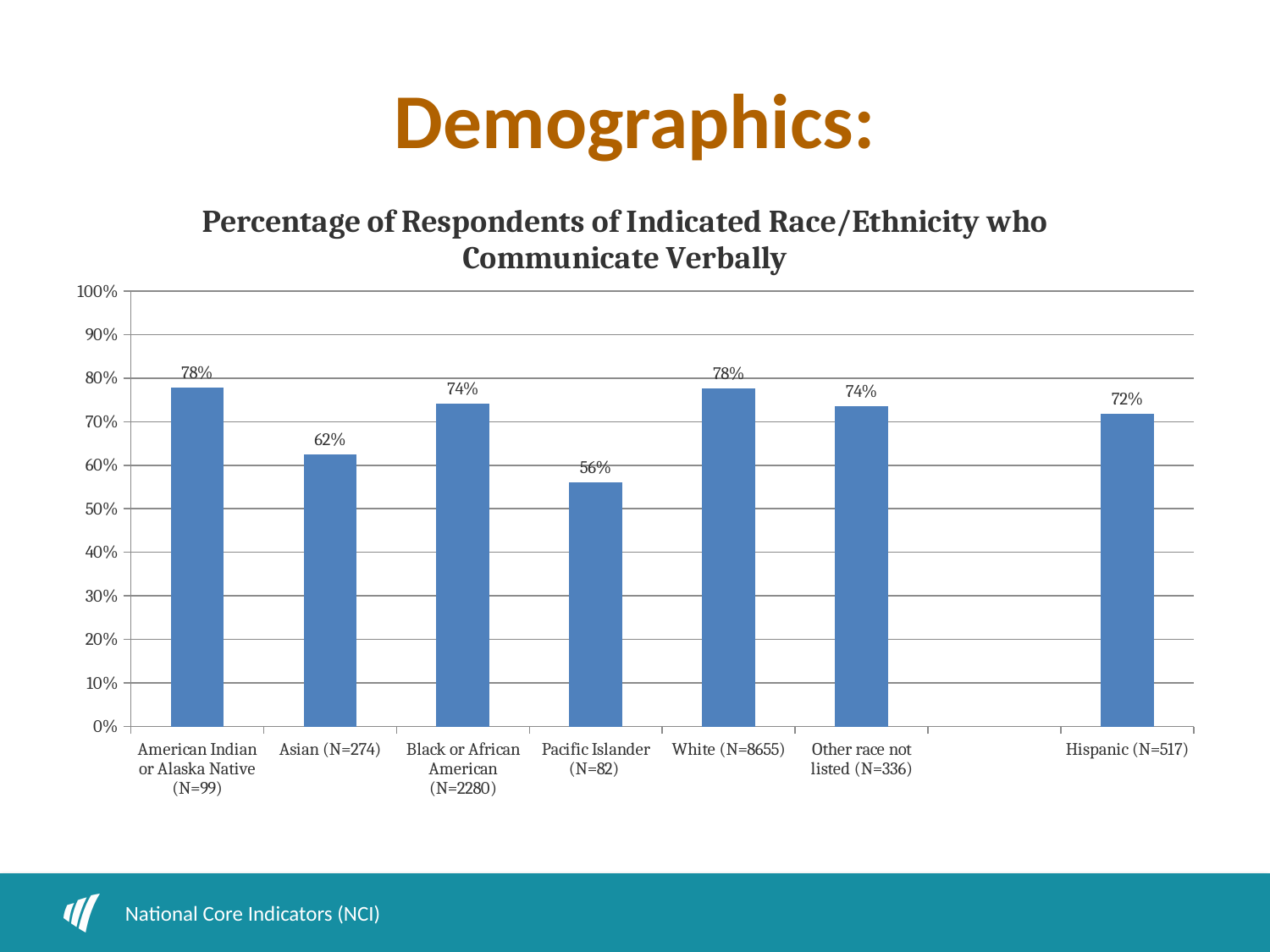
What is the difference between the percentage for White (N=8655) and the percentage for Pacific Islander (N=82)? 22% What is the value shown for Pacific Islander (N=82)? 56% What percentage of Hispanic respondents (N=517) communicate verbally? 72% What type of chart is shown on the slide? Bar chart Which is larger, the value for Asian (N=274) or the value for Hispanic (N=517)? Hispanic (N=517) Which race/ethnicity group has the lowest percentage of respondents who communicate verbally? Pacific Islander (N=82) How many bars are plotted in the chart? 7 What percentage of Asian respondents (N=274) communicate verbally? 62% What is the value for White (N=8655)? 78% What is the difference between the values for Black or African American (N=2280) and Asian (N=274)? 12% Is the value for Pacific Islander (N=82) greater or less than 60%? less What is the title of the chart? Percentage of Respondents of Indicated Race/Ethnicity who Communicate Verbally